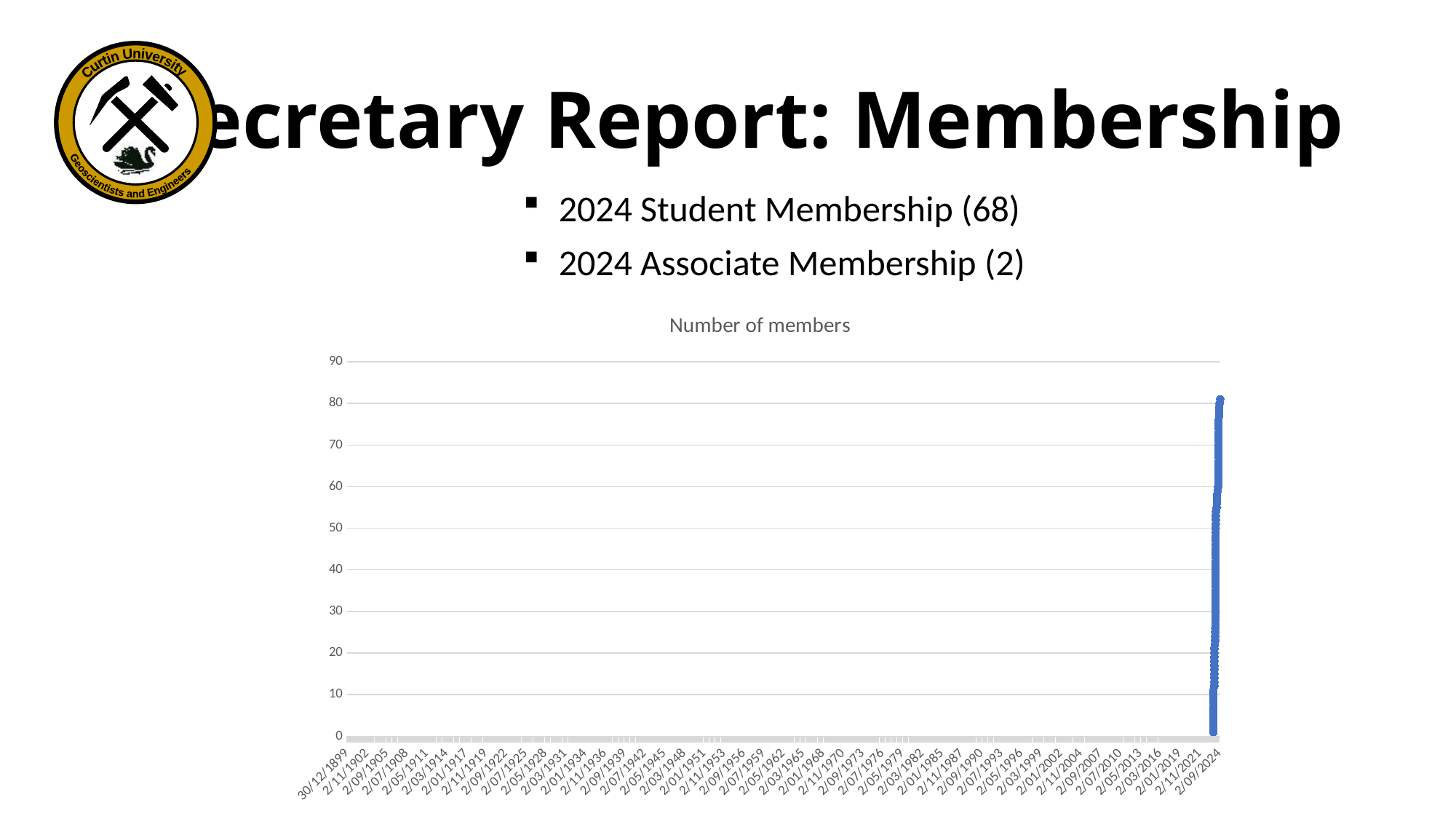
What is the title of the chart? Number of members Is the lowest value plotted in the chart greater or less than 10? less What is the last date label shown on the x axis of the chart? 2/09/2024 Is the highest value plotted in the chart greater or less than 70? greater What is the highest tick value shown on the y axis of the chart? 90 What is the first date label shown on the x axis of the chart? 30/12/1899 Do the values in the chart rise or fall along the x axis? rise What kind of chart is shown on the slide? line chart